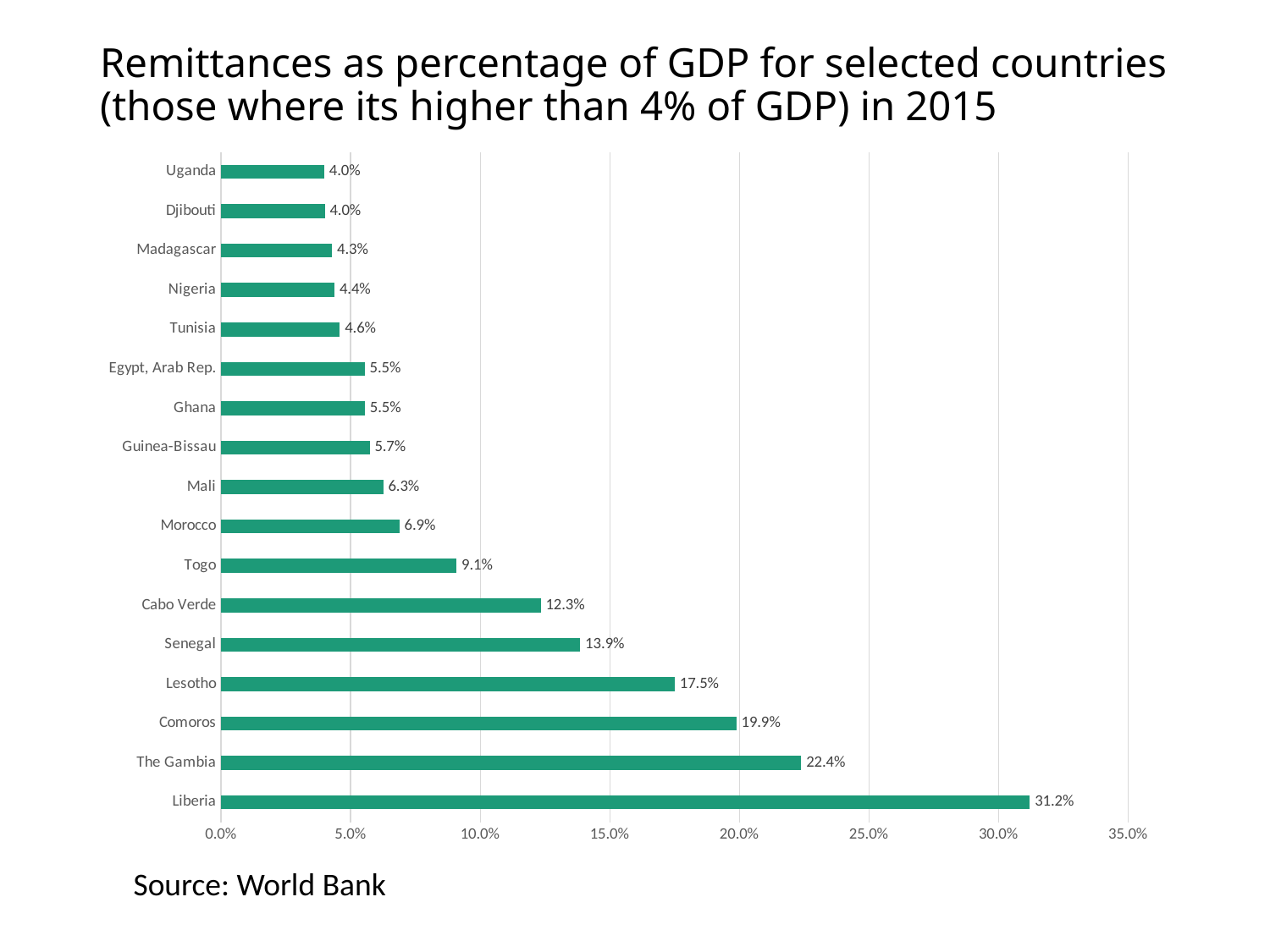
Which has a larger value, Togo or Mali? Togo Which has a larger value, Cabo Verde or Senegal? Senegal What is the difference between the values for The Gambia and Comoros? 2.5% What is the source cited for the chart data? World Bank Which country has the highest remittances as percentage of GDP? Liberia What is the difference between the values for Lesotho and Cabo Verde? 5.2% Is the value for Comoros greater or less than 15.0%? greater What is the remittances as percentage of GDP value for Liberia? 31.2% What is the value shown for Morocco? 6.9% What kind of chart is shown on the slide? Bar chart What is the value shown for Senegal? 13.9% How many countries are shown in the chart? 17